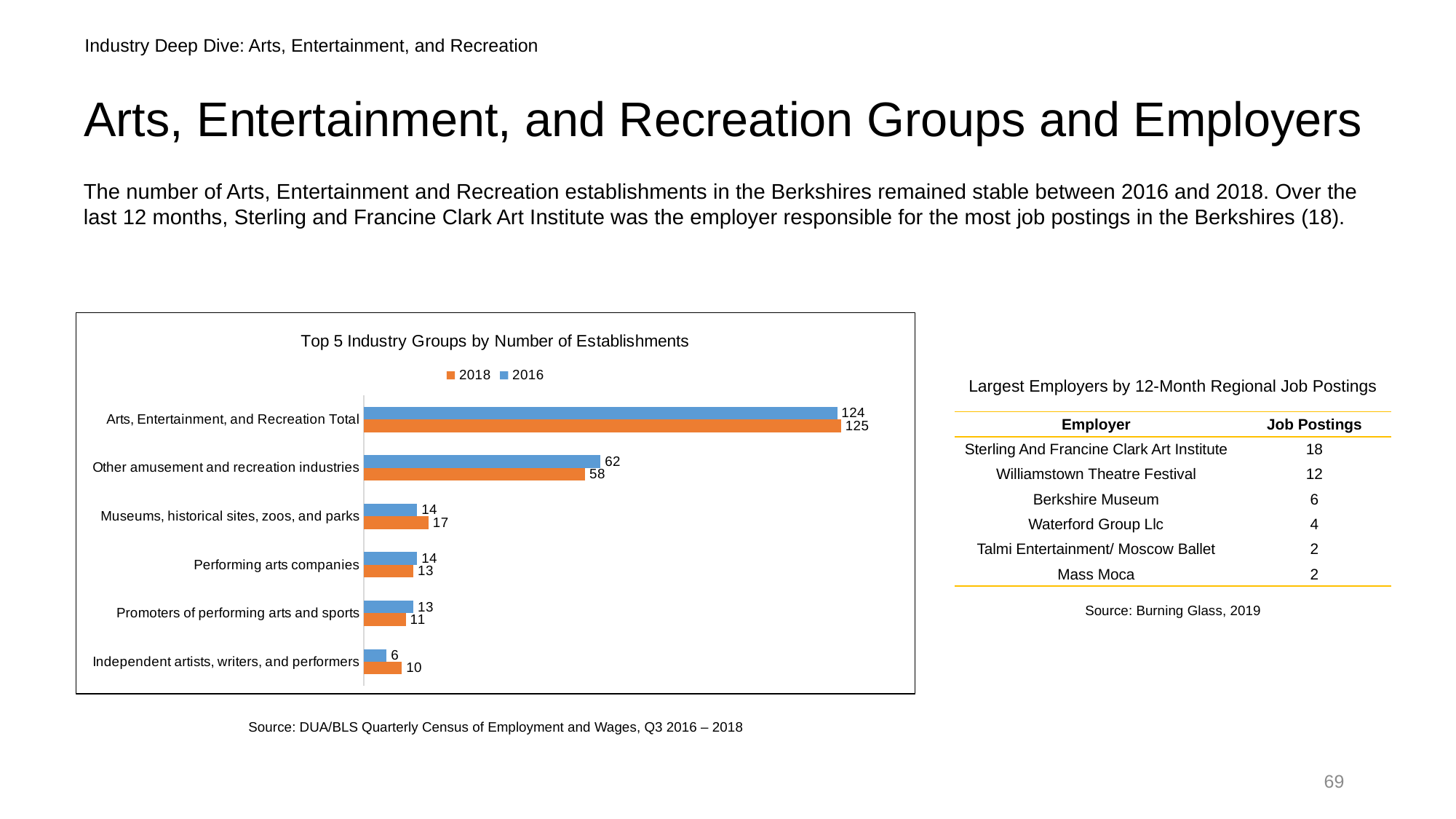
For Museums, historical sites, zoos, and parks, which year has the larger value, 2016 or 2018? 2018 What is the 2016 value for Museums, historical sites, zoos, and parks? 14 What is the 2018 value for Other amusement and recreation industries in the Top 5 Industry Groups by Number of Establishments chart? 58 For Promoters of performing arts and sports, which year has the larger value, 2016 or 2018? 2016 Which industry group has the lowest number of establishments in 2016? Independent artists, writers, and performers What is the 2018 value for Independent artists, writers, and performers? 10 What is the 2016 value for Arts, Entertainment, and Recreation Total? 124 How many categories are shown in the Top 5 Industry Groups by Number of Establishments chart? 6 Excluding the Total category, which industry group has the highest number of establishments in 2018? Other amusement and recreation industries How many series does the legend of the chart list? 2 What is the difference between the 2016 and 2018 values for Other amusement and recreation industries? 4 What kind of chart is Top 5 Industry Groups by Number of Establishments? Bar chart